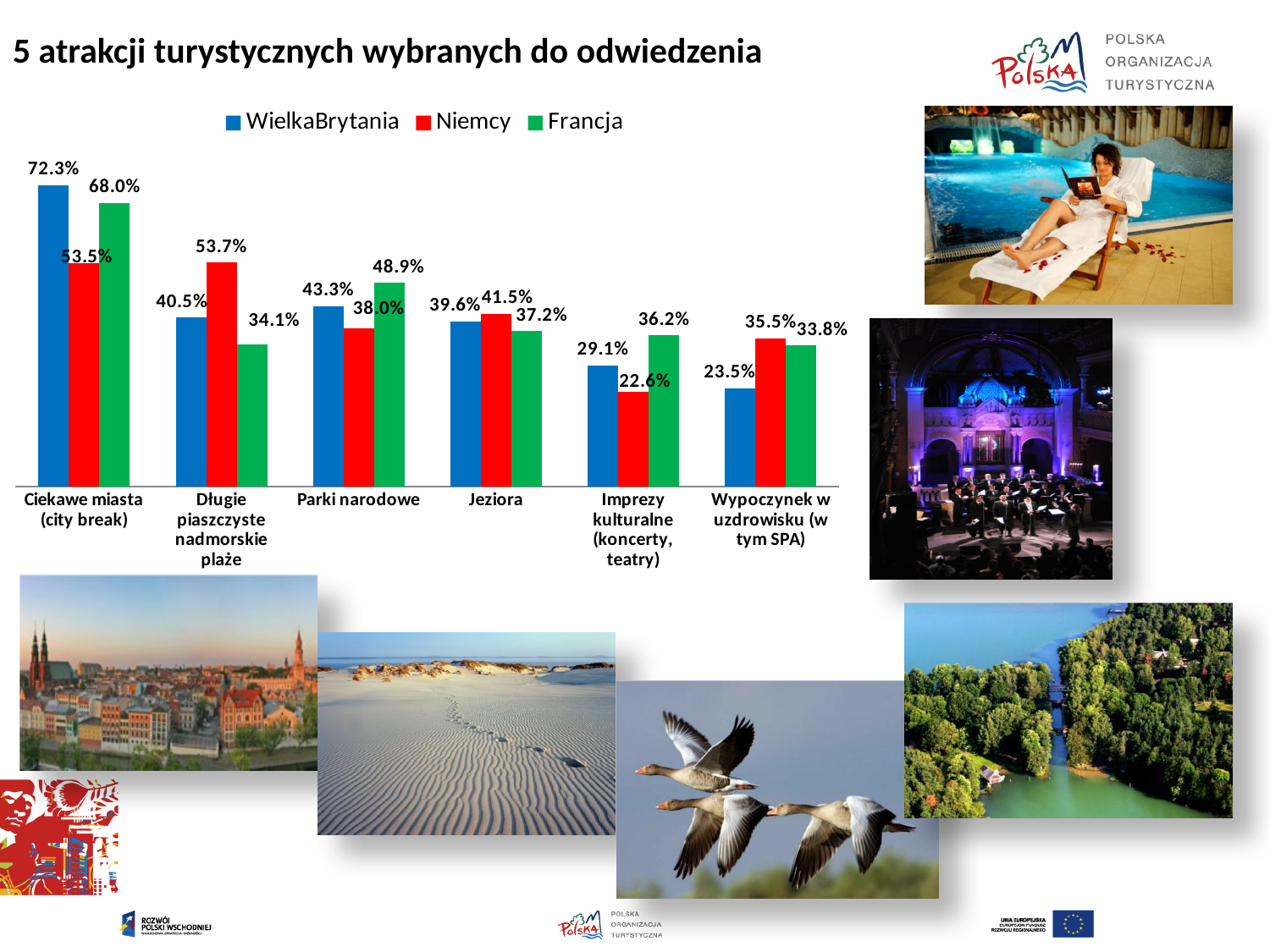
Which is larger for Wypoczynek w uzdrowisku (w tym SPA): the value for WielkaBrytania or the value for Niemcy? Niemcy What is the value for Francja in the category Parki narodowe? 48.9% Which category has the highest value for WielkaBrytania? Ciekawe miasta (city break) What is the difference between the WielkaBrytania and Francja values for Ciekawe miasta (city break)? 4.3% Which category has the lowest value for Niemcy? Imprezy kulturalne (koncerty, teatry) How many categories are shown on the x axis of the chart? 6 What is the value for Niemcy in the category Długie piaszczyste nadmorskie plaże? 53.7% How many series does the chart legend list? 3 What is the value for Niemcy in the category Imprezy kulturalne (koncerty, teatry)? 22.6% What is the value for WielkaBrytania in the category Ciekawe miasta (city break)? 72.3% Which colour represents the Francja series in the chart? green What kind of chart is shown on the slide? bar chart